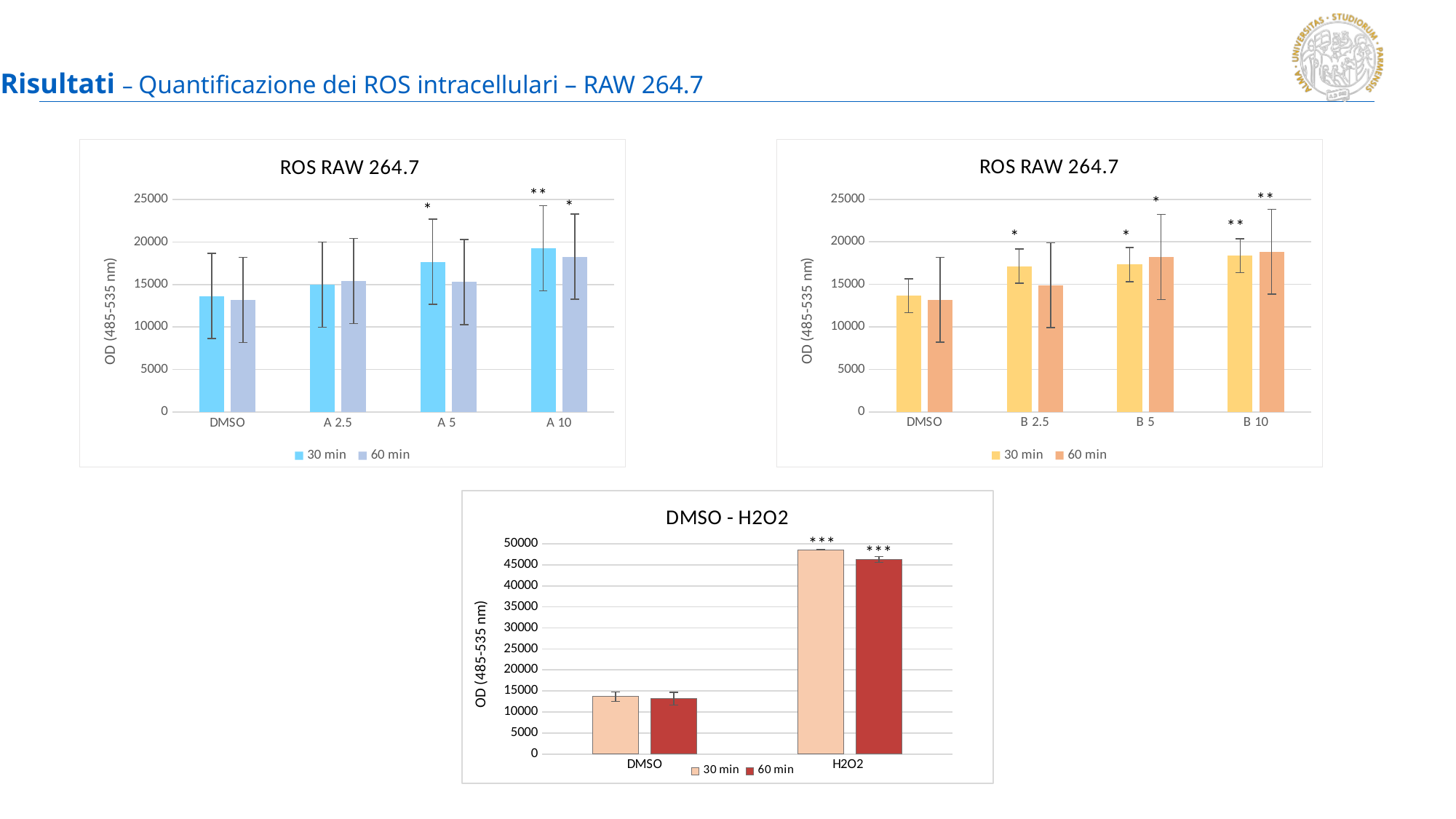
In the top-right chart (ROS RAW 264.7), how many series does the legend list? 2 In the top-right chart (ROS RAW 264.7), is the 60 min value for B 10 greater or less than 15000? greater In the top-left chart (ROS RAW 264.7), which category has the highest 30 min value? A 10 What type of chart is the bottom chart titled "DMSO - H2O2"? bar chart In the top-right chart (ROS RAW 264.7), which category has the lowest 60 min value? DMSO In the bottom chart (DMSO - H2O2), how many categories are shown on the x axis? 2 In the bottom chart (DMSO - H2O2), is the 30 min value for H2O2 greater or less than 45000? greater In the top-left chart (ROS RAW 264.7), how many categories are shown on the x axis? 4 In the bottom chart (DMSO - H2O2), which is larger: the 30 min value for DMSO or the 30 min value for H2O2? H2O2 In the top-left chart (ROS RAW 264.7), which category has the lowest 30 min value? DMSO In the top-left chart (ROS RAW 264.7), do the 30 min values rise or fall from DMSO to A 10? rise In the top-left chart (ROS RAW 264.7), is the 30 min value for A 10 greater or less than 15000? greater